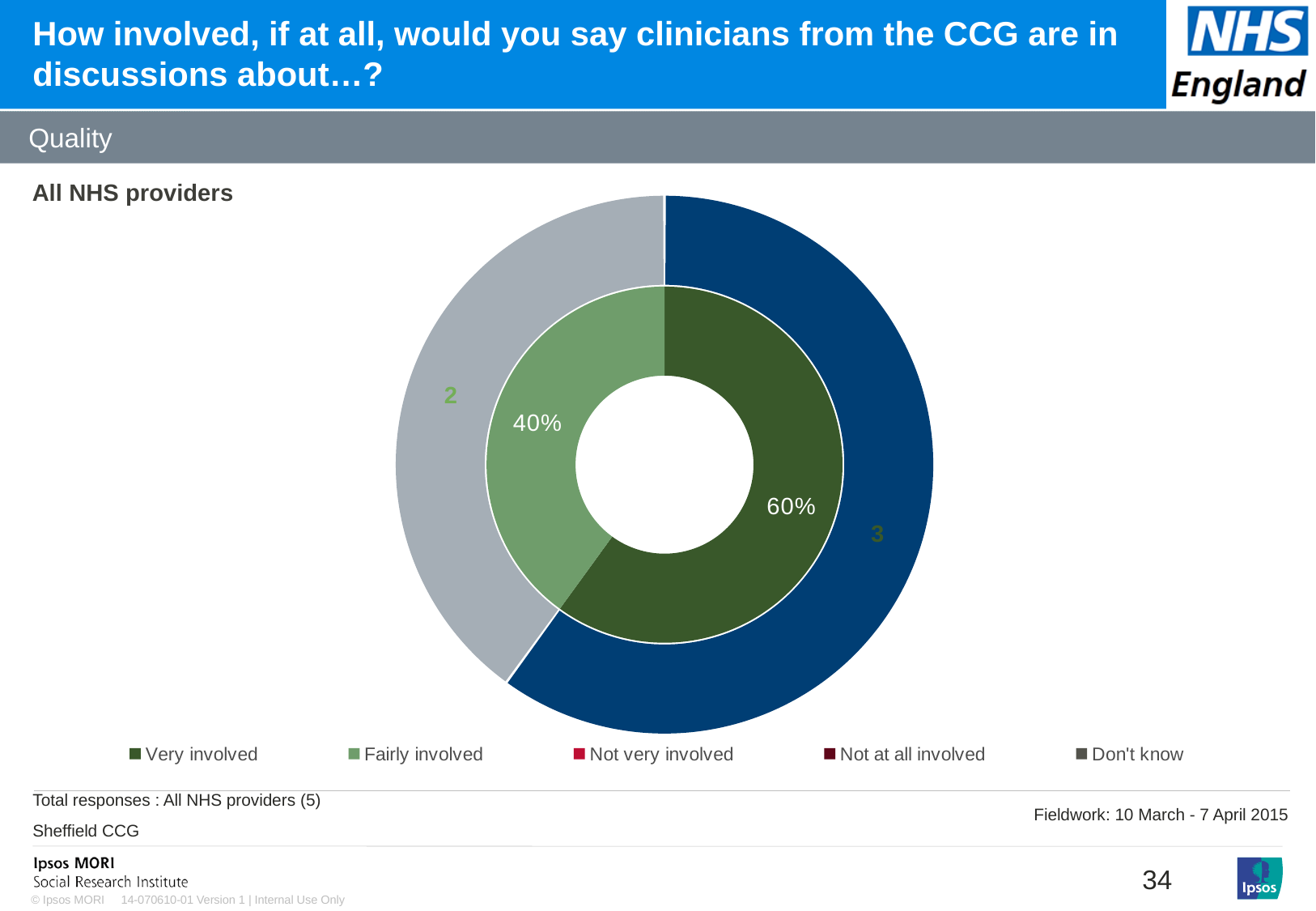
What percentage of responses are 'Fairly involved'? 40% How many response categories have a non-zero share plotted in the chart? 2 Which of the two plotted response categories has the smaller share? Fairly involved What number of responses is shown on the outer ring for the 'Very involved' segment? 3 Which response category has the largest share of the chart? Very involved Which is larger, the share for 'Very involved' or for 'Fairly involved'? Very involved How many response categories does the legend list? 5 What is the difference in percentage points between 'Very involved' and 'Fairly involved'? 20 percentage points What is the total number of responses shown across the outer ring segments? 5 What percentage of responses are 'Very involved'? 60% What number of responses is shown on the outer ring for the 'Fairly involved' segment? 2 What kind of chart is shown on the slide? doughnut chart